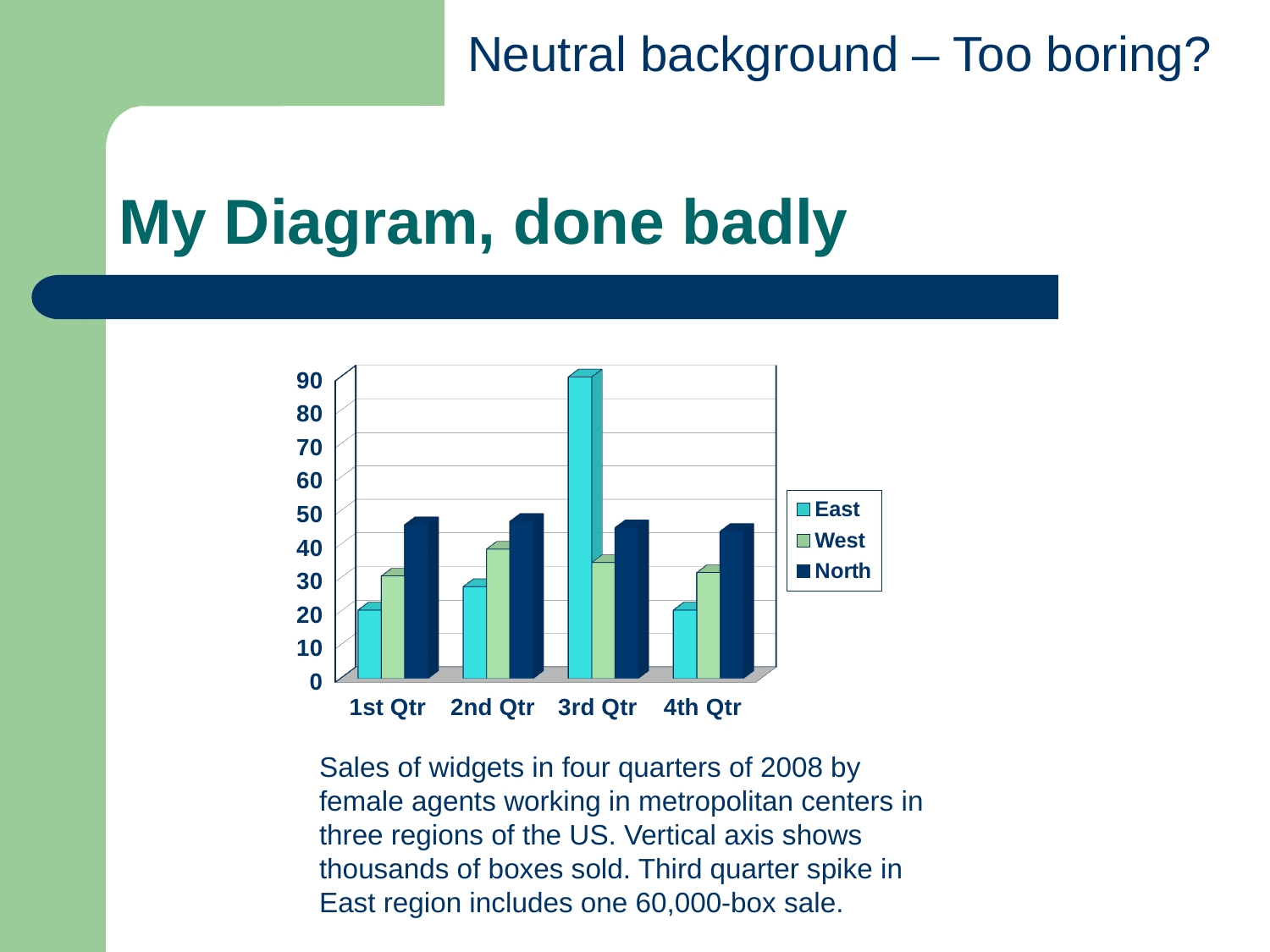
Is the value for East in the 1st Qtr greater or less than 30? less What are the three series named in the legend? East, West, North In which quarter is the East series highest? 3rd Qtr Is the value for West in the 2nd Qtr greater or less than 30? greater Which series has the tallest bar in the 3rd Qtr? East Which is larger in the 1st Qtr, East or North? North What kind of chart is shown on the slide? bar chart Is the value for East in the 3rd Qtr greater or less than 80? greater How many series does the legend list? 3 Which is larger in the 3rd Qtr, East or West? East How many quarters are shown on the x axis? 4